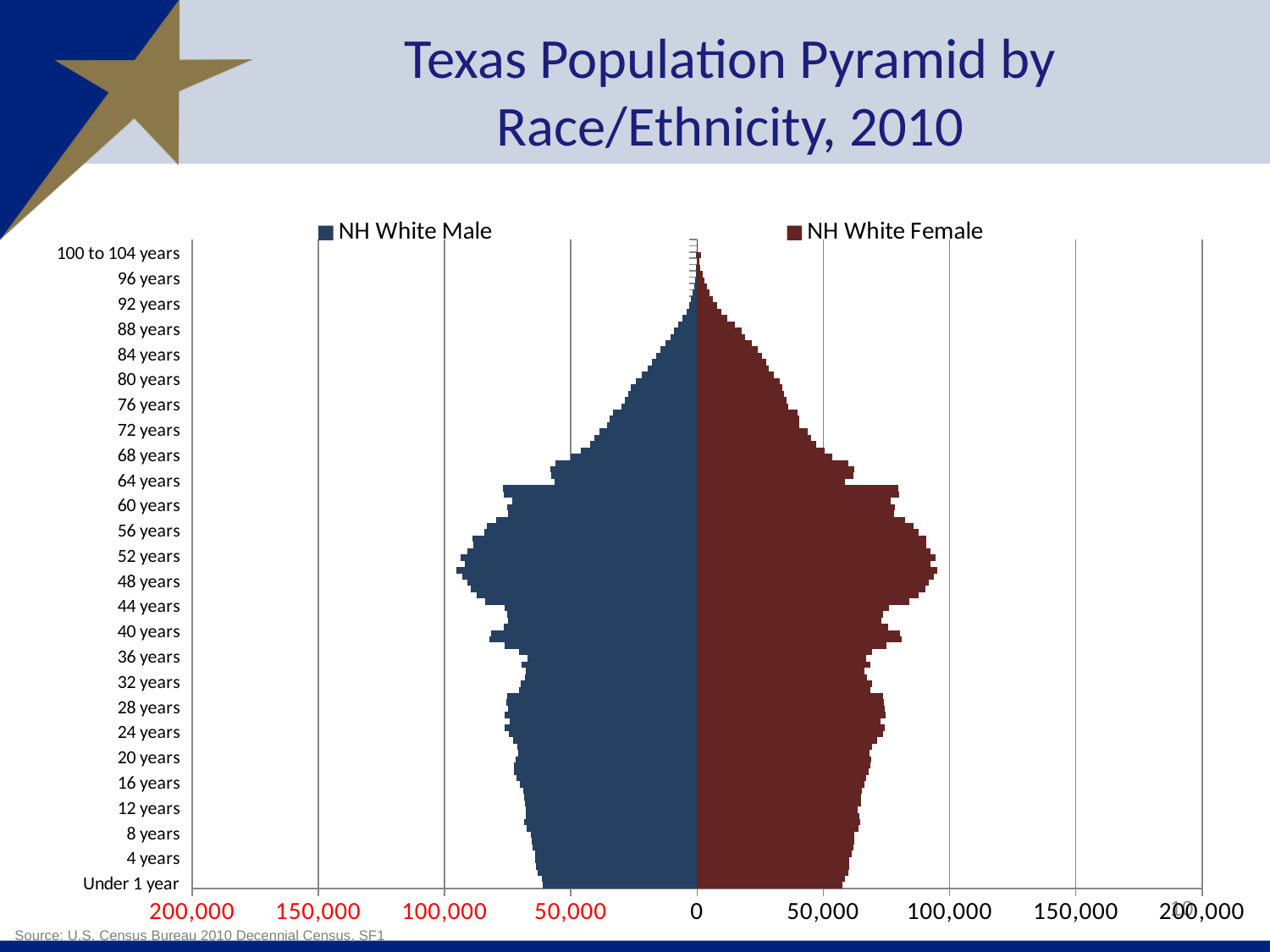
What are the two series named in the legend? NH White Male and NH White Female Is the value for NH White Male at 92 years greater or less than 50,000? less Which is larger: the NH White Male value at 48 years or the NH White Male value at 88 years? 48 years How many series does the legend list? 2 Is the value for NH White Male at 48 years greater or less than 50,000? greater Do the NH White Female values rise or fall as age increases from 64 years to 100 to 104 years? fall What kind of chart is shown on the slide? Bar chart (population pyramid) What is the title of the chart? Texas Population Pyramid by Race/Ethnicity, 2010 Is the value for NH White Female at 48 years greater or less than 50,000? greater